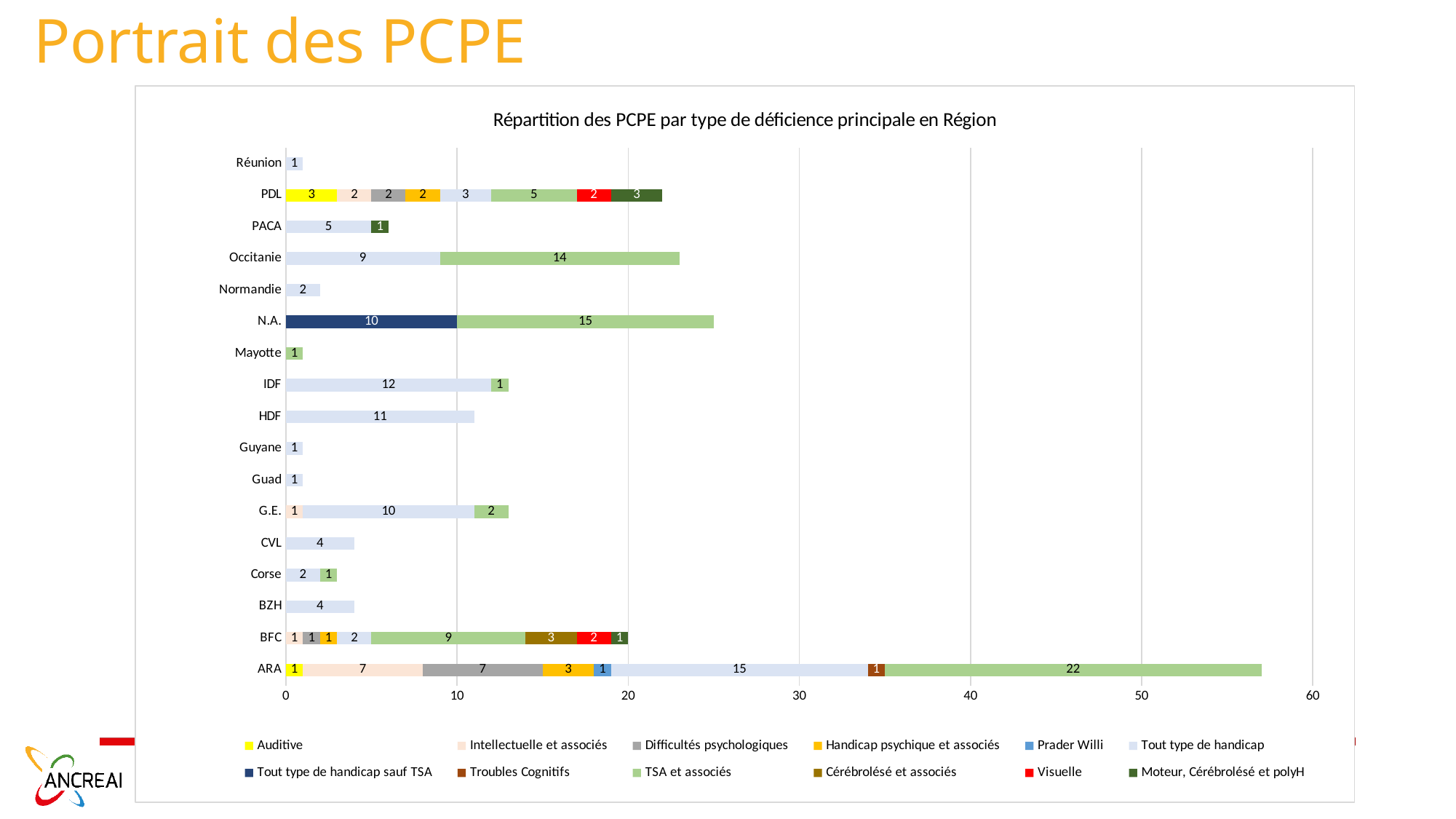
What is the value of 'Tout type de handicap' for HDF? 11 What is the value of 'TSA et associés' for ARA? 22 Which is larger: the 'Tout type de handicap' value for IDF or for G.E.? IDF How many series does the legend list? 12 What is the value of 'TSA et associés' for Occitanie? 14 What type of chart is shown on the slide? Stacked bar chart What is the difference between the 'TSA et associés' value for N.A. and for Occitanie? 1 What is the title of the chart? Répartition des PCPE par type de déficience principale en Région Which region has the longest total bar? ARA How many regions (categories) are shown on the chart? 17 What is the total of the stacked bar for ARA? 57 What is the total of the stacked bar for N.A.? 25